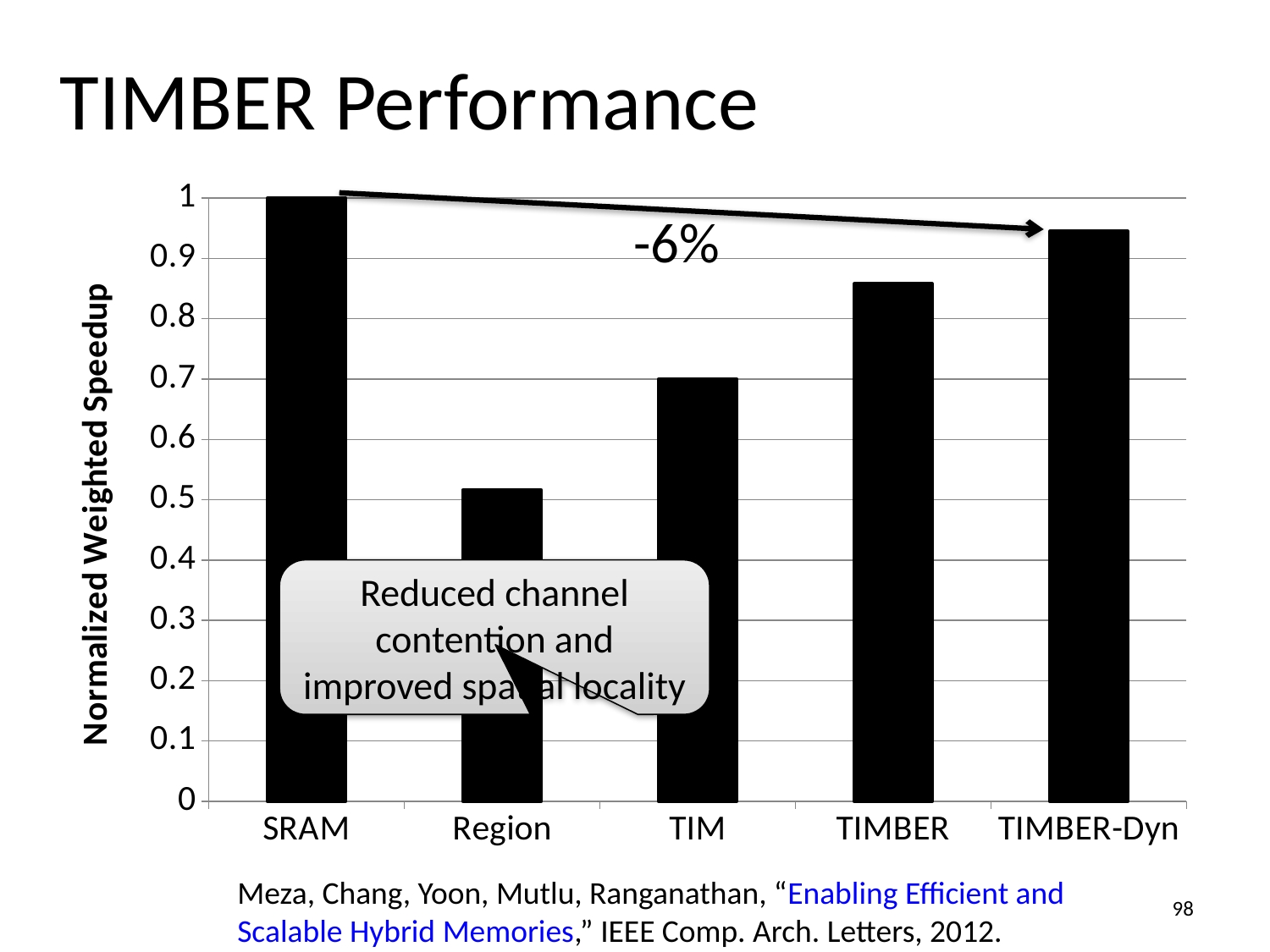
Which category has the highest normalized weighted speedup? SRAM Which has a higher normalized weighted speedup, TIMBER or TIMBER-Dyn? TIMBER-Dyn Which category has the lowest normalized weighted speedup? Region What is the label on the y axis of the chart? Normalized Weighted Speedup What percentage change is annotated by the arrow from SRAM to TIMBER-Dyn? -6% What is the normalized weighted speedup for SRAM? 1 How many categories are shown on the x axis of the chart? 5 Which has a higher normalized weighted speedup, TIM or Region? TIM Is the value for TIMBER-Dyn greater or less than 0.9? greater Is the value for TIMBER greater or less than 0.8? greater What kind of chart is shown on the slide? bar chart Is the value for Region greater or less than 0.6? less